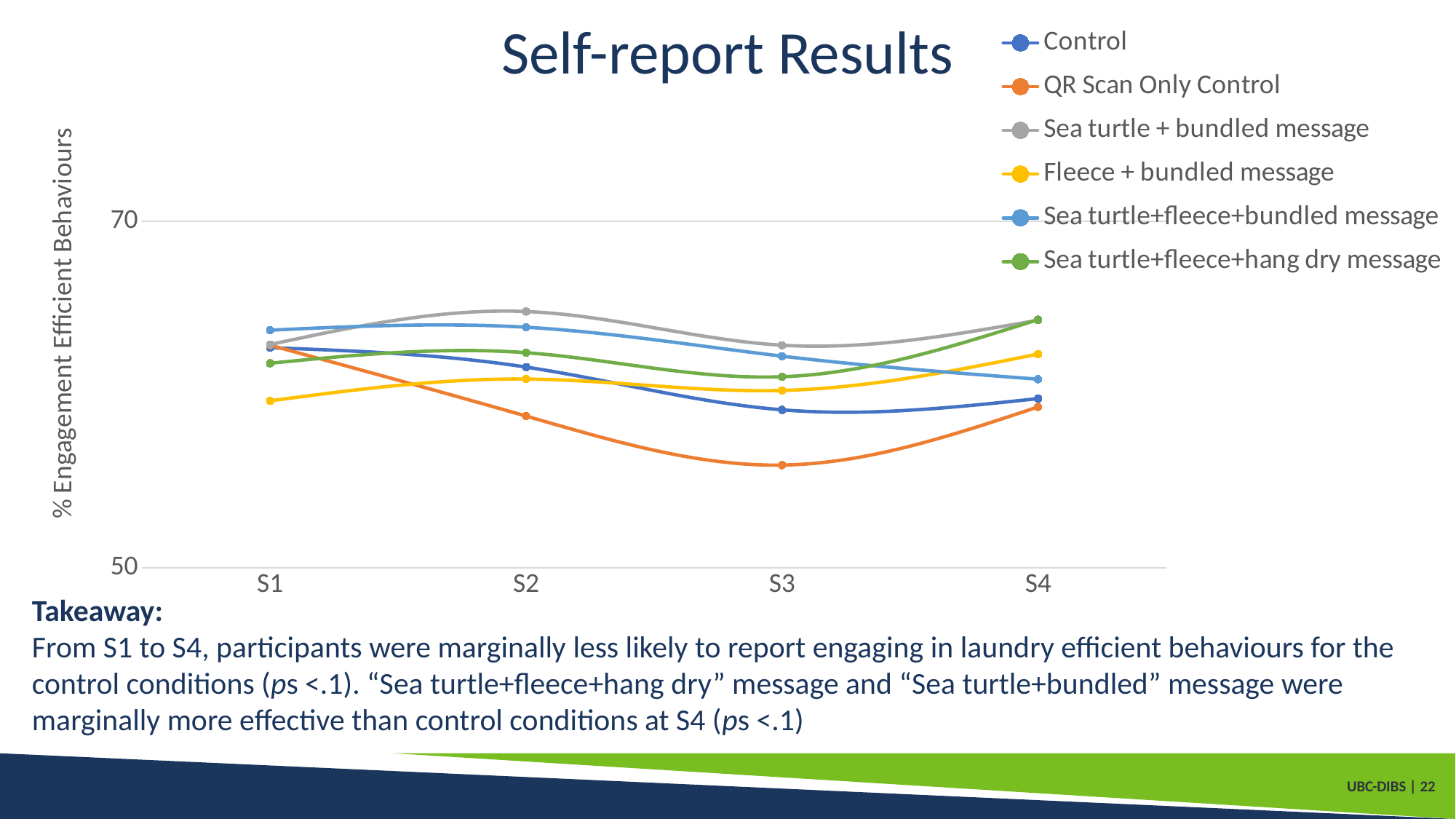
Which series has the lowest value at S1? Fleece + bundled message Which series has the highest value at S2? Sea turtle + bundled message How many series does the legend list? 6 Which series has the lowest value at S3? QR Scan Only Control How many time points are shown on the x axis? 4 At S3, which is larger: Sea turtle + bundled message or Control? Sea turtle + bundled message Does the Sea turtle+fleece+hang dry message series rise or fall from S3 to S4? rise What is the label on the y axis? % Engagement Efficient Behaviours What kind of chart is shown on the slide? line chart Is the value for QR Scan Only Control at S3 greater or less than 70? less Does the QR Scan Only Control series rise or fall from S1 to S3? fall Which series has the highest value at S1? Sea turtle+fleece+bundled message